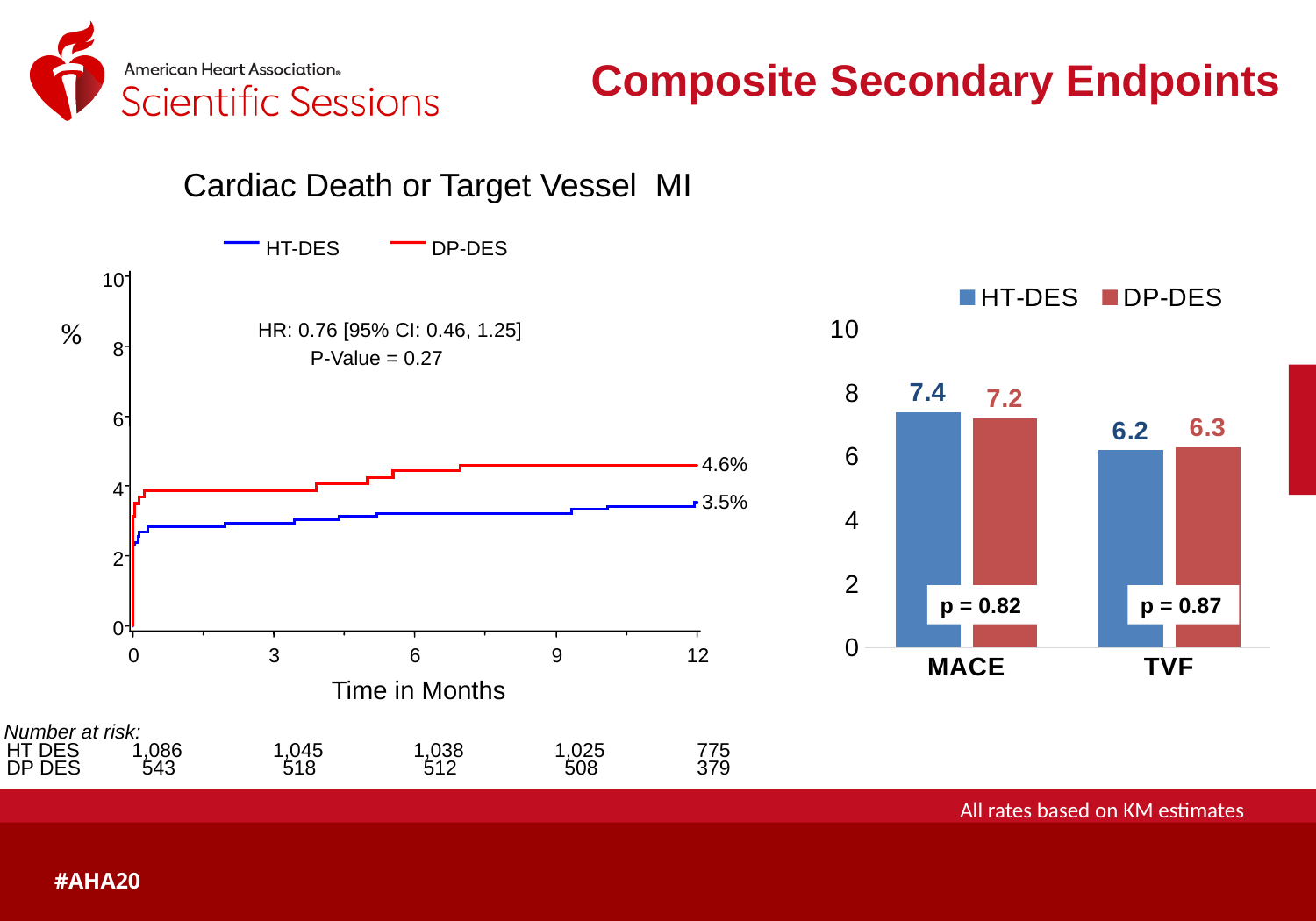
In the bar chart on the right, how many categories are shown on the x axis? 2 In the bar chart on the right, what is the value for DP-DES in the TVF category? 6.3 In the bar chart on the right, what p-value is shown for the MACE comparison? p = 0.82 In the bar chart on the right, what is the value for HT-DES in the MACE category? 7.4 In the 'Cardiac Death or Target Vessel MI' chart, do the curves rise or fall over time in months? Rise What kind of chart is shown on the right side of the slide? Bar chart In the 'Cardiac Death or Target Vessel MI' chart, what hazard ratio is reported? HR: 0.76 [95% CI: 0.46, 1.25] In the bar chart on the right, how many series does the legend list? 2 In the bar chart on the right, what is the difference between the HT-DES and DP-DES values for MACE? 0.2 In the 'Cardiac Death or Target Vessel MI' chart, what is the rate for HT-DES at 12 months? 3.5% In the bar chart on the right, which series has the higher value for TVF? DP-DES In the 'Cardiac Death or Target Vessel MI' chart, what is the rate for DP-DES at 12 months? 4.6%